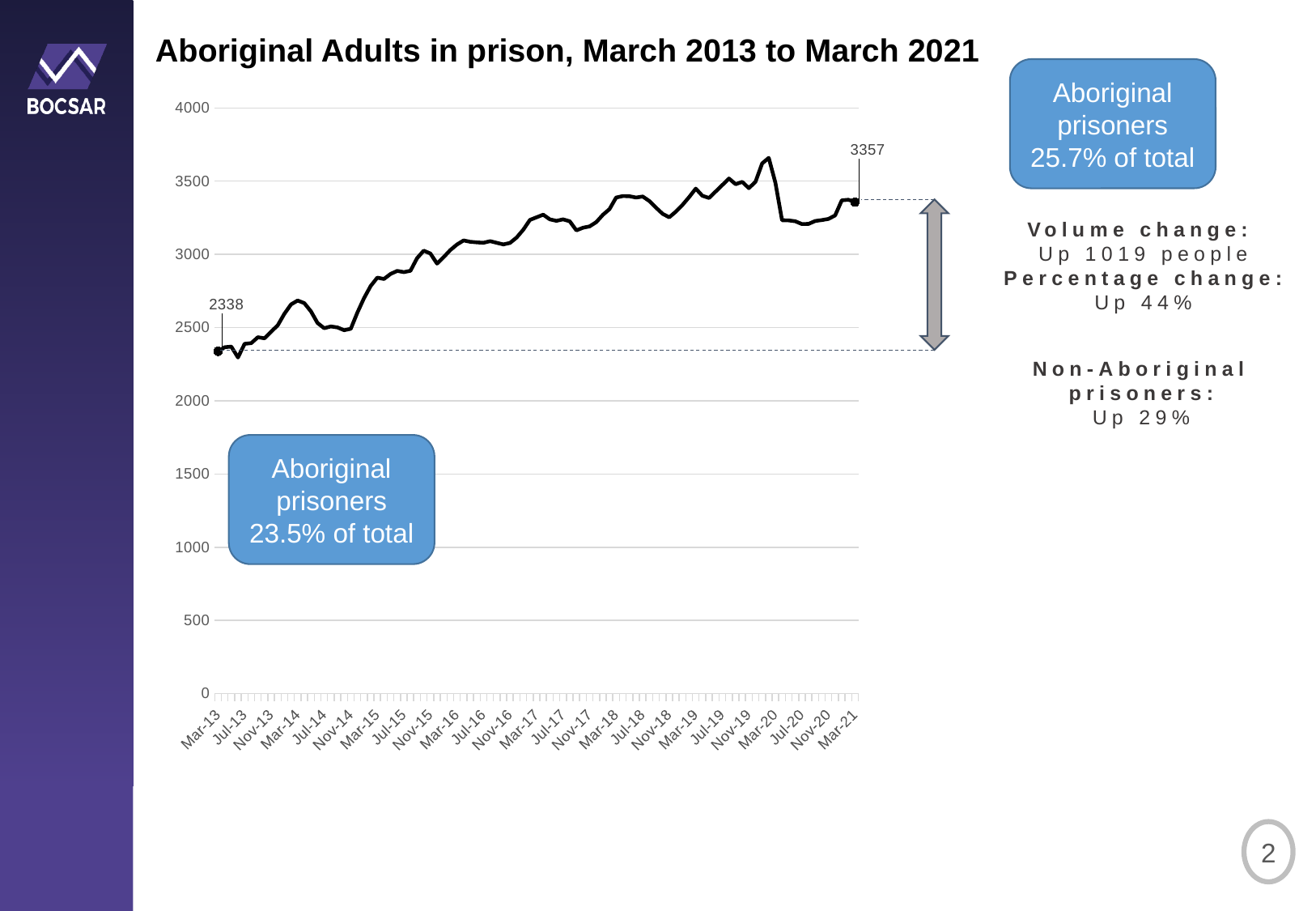
Is the value for Mar-13 greater or less than 2500? less Do the values generally rise or fall from Mar-13 to Mar-21? Rise Is the peak value around Mar-20 greater or less than 3500? greater What is the value of the data label at Mar-13 on the line chart? 2338 Is the value for Jul-20 greater or less than 3500? less What kind of chart is shown on the slide? Line chart Which labelled point is higher, Mar-13 or Mar-21? Mar-21 What is the difference between the labelled values at Mar-21 and Mar-13? 1019 What is the title of the chart? Aboriginal Adults in prison, March 2013 to March 2021 What is the value of the data label at Mar-21 on the line chart? 3357 What is the highest tick value shown on the y axis? 4000